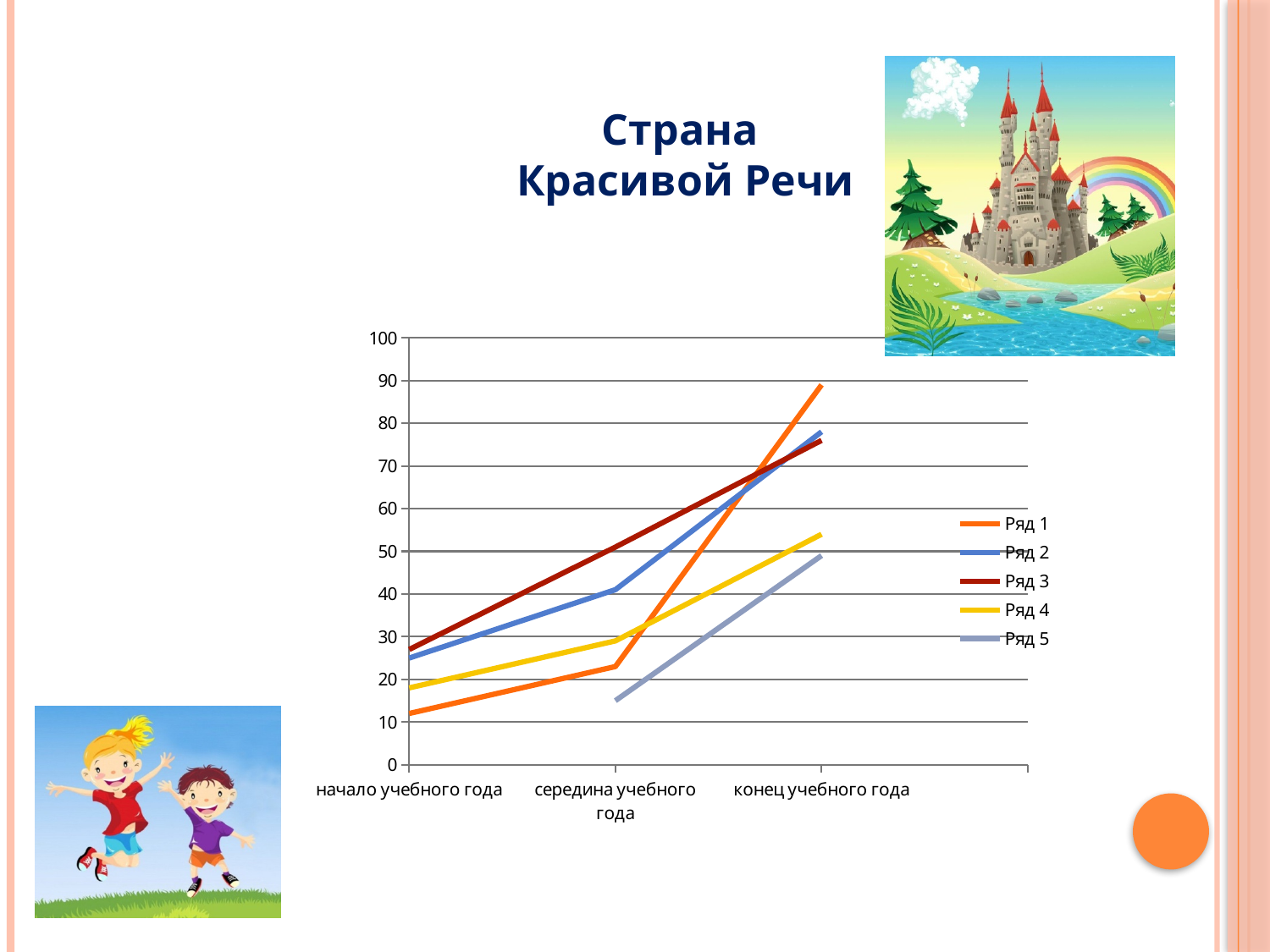
What kind of chart is shown on the slide? line chart How many series does the legend list? 5 Is the value for Ряд 1 at конец учебного года greater or less than 80? greater Is the value for Ряд 2 at конец учебного года greater or less than 70? greater Which series has the lowest value at начало учебного года? Ряд 1 At конец учебного года, which is larger: Ряд 1 or Ряд 2? Ряд 1 Is the value for Ряд 1 at начало учебного года greater or less than 20? less How many categories are shown on the x axis? 3 Do the values for Ряд 1 rise or fall from начало учебного года to конец учебного года? rise Which series has the highest value at конец учебного года? Ряд 1 Which series is listed first in the legend? Ряд 1